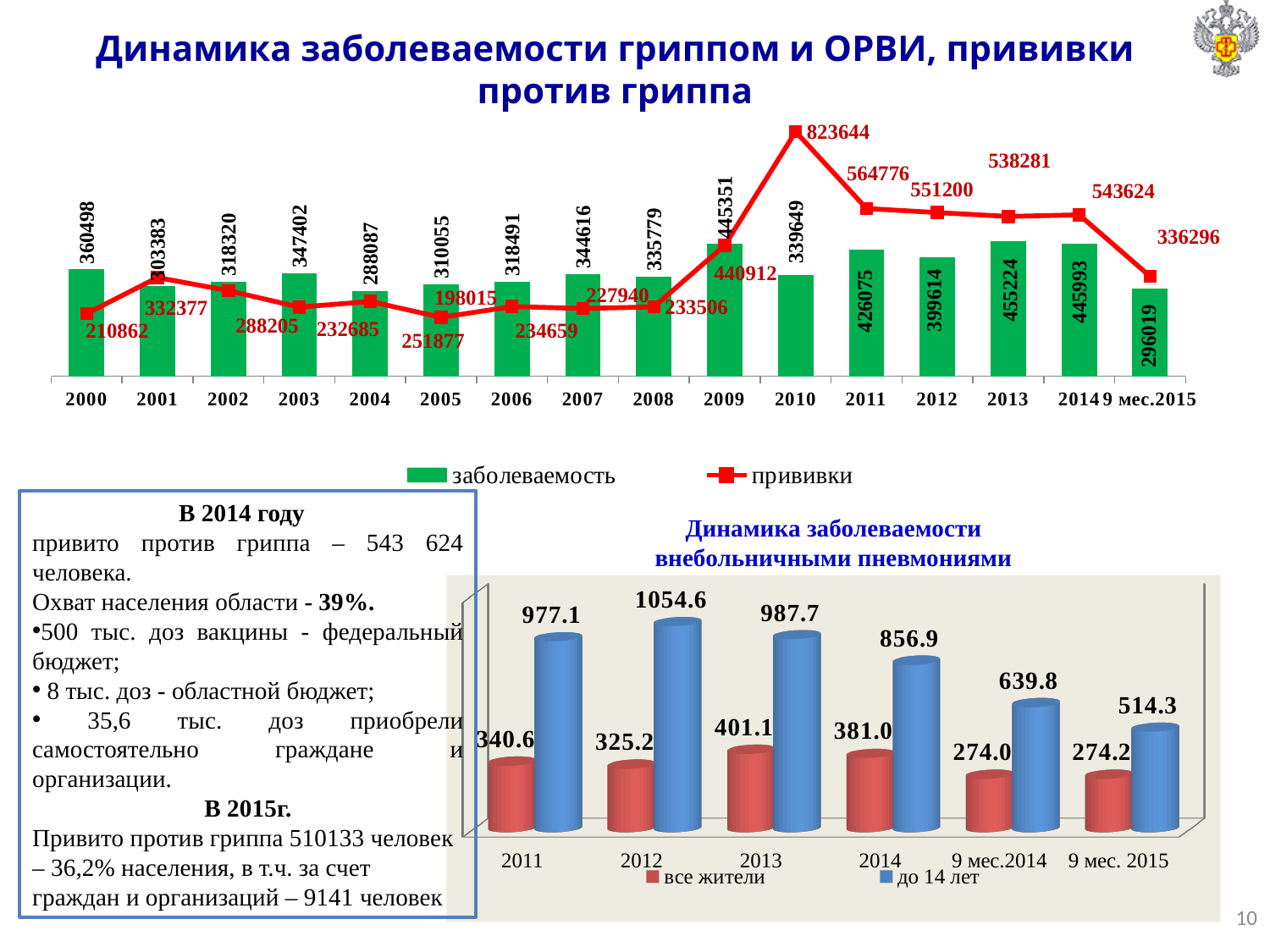
In the chart 'Динамика заболеваемости внебольничными пневмониями', how many categories are shown on the x axis? 6 What kind of chart is 'Динамика заболеваемости внебольничными пневмониями'? bar chart In the top chart, which category has the lowest заболеваемость bar? 2004 In the top chart, how many series does the legend list? 2 In the top chart, which year has the lowest прививки value? 2005 In the top chart, which year has the highest прививки value? 2010 In the chart 'Динамика заболеваемости внебольничными пневмониями', what is the value for до 14 лет in 2012? 1054.6 In the chart 'Динамика заболеваемости внебольничными пневмониями', which category has the highest value for до 14 лет? 2012 In the top chart, what is the прививки value for 2010? 823644 In the top chart, what is the заболеваемость value for 2000? 360498 In the top chart, what is the difference between the заболеваемость values for 2013 and 2012? 55610 In the chart 'Динамика заболеваемости внебольничными пневмониями', what is the difference between до 14 лет and все жители in 2013? 586.6